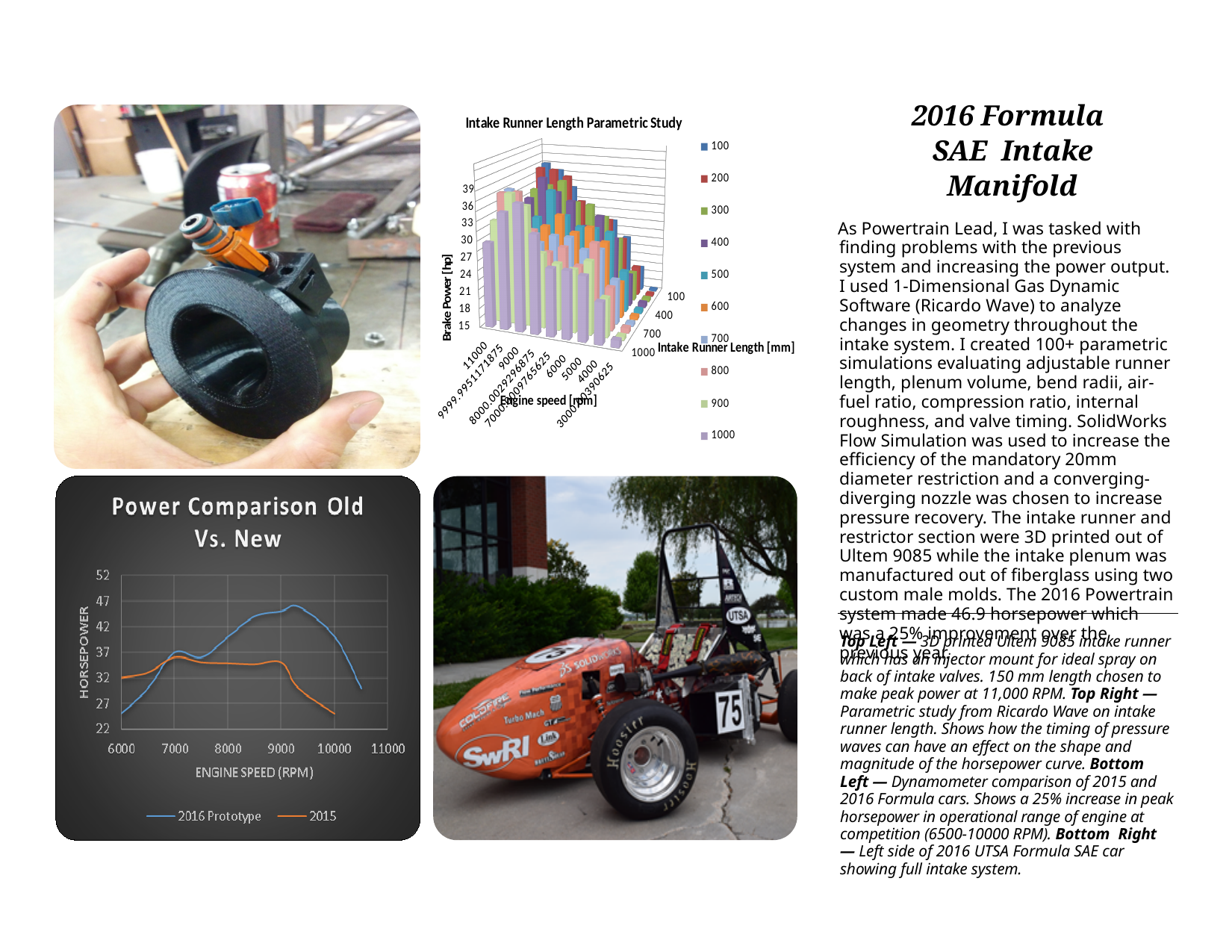
In the 'Intake Runner Length Parametric Study' chart, what is the highest tick value shown on the Brake Power axis? 39 In the 'Power Comparison Old Vs. New' chart, is the 2016 Prototype horsepower at 9000 RPM greater or less than 42? greater What is the vertical axis label of the 'Intake Runner Length Parametric Study' chart? Brake Power [hp] In the 'Power Comparison Old Vs. New' chart, is the 2015 horsepower at 9000 RPM greater or less than 42? less In the 'Power Comparison Old Vs. New' chart, which series has the higher horsepower at 8000 RPM, 2016 Prototype or 2015? 2016 Prototype How many series does the legend of the 'Power Comparison Old Vs. New' chart list? 2 What type of chart is the 'Intake Runner Length Parametric Study' chart? bar chart What type of chart is the 'Power Comparison Old Vs. New' chart? line chart In the 'Power Comparison Old Vs. New' chart, which series has the higher horsepower at 6500 RPM, 2016 Prototype or 2015? 2015 In the 'Power Comparison Old Vs. New' chart, which series is drawn in blue? 2016 Prototype How many series does the legend of the 'Intake Runner Length Parametric Study' chart list? 10 In the 'Power Comparison Old Vs. New' chart, does the 2016 Prototype horsepower rise or fall between 6000 RPM and 9000 RPM? rise